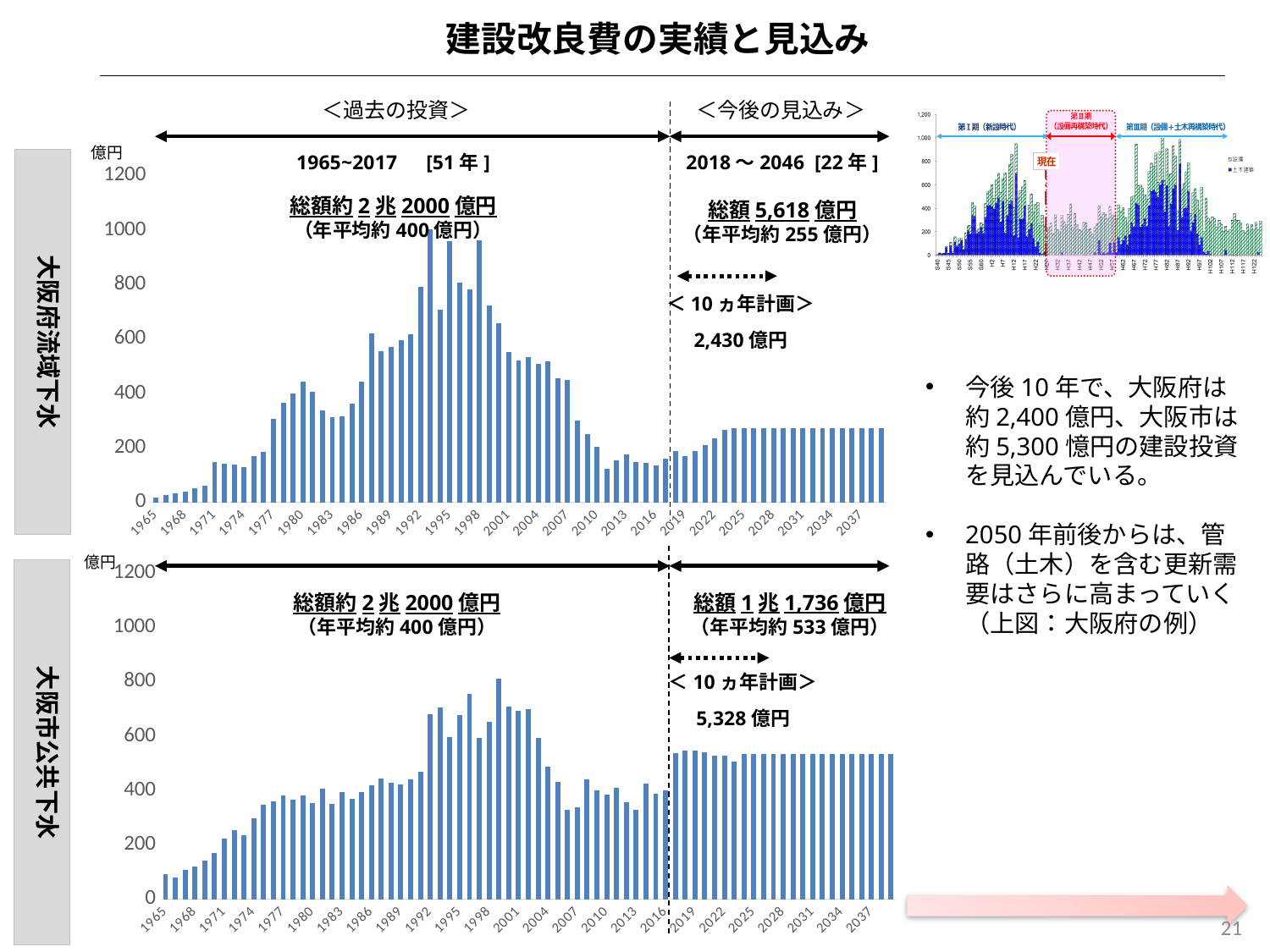
In the top chart (大阪府流域下水), is the value for 2025 greater or less than 400? less What kind of chart is the top chart labelled 大阪府流域下水? bar chart In the bottom chart (大阪市公共下水), is the value for 2031 greater or less than 400? greater In the bottom chart (大阪市公共下水), do the values generally rise or fall from 1965 to 1980? rise What kind of chart is the bottom chart labelled 大阪市公共下水? bar chart In the top chart (大阪府流域下水), do the values generally rise or fall from 1997 to 2016? fall In the top chart (大阪府流域下水), is the value for 2013 greater or less than 200? less What is the title of the slide containing the two charts? 建設改良費の実績と見込み In the top chart (大阪府流域下水), what unit is shown on the y axis? 億円